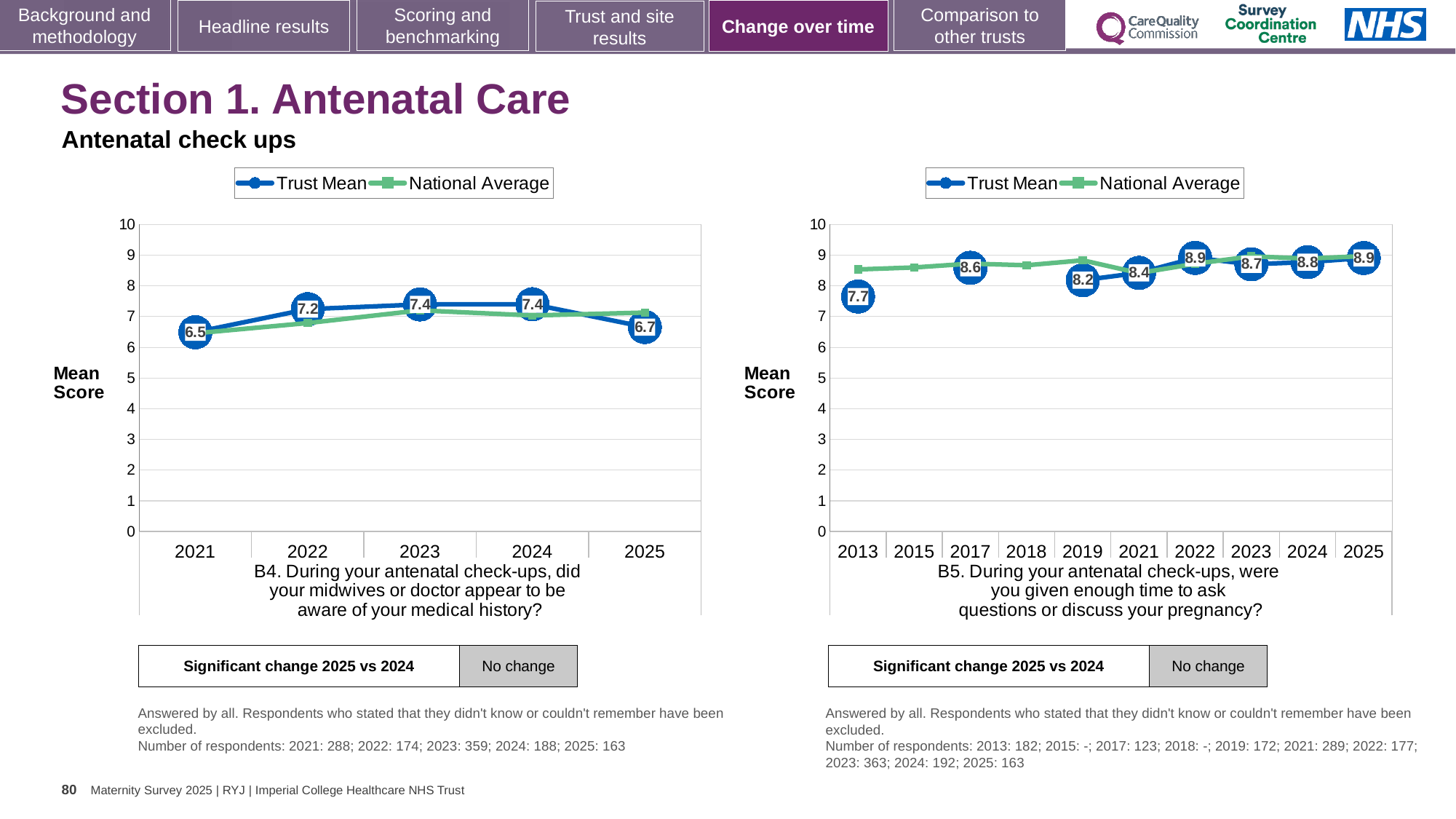
What type of chart is the left chart (B4)? Line chart In the left chart (B4), what is the Trust Mean for 2025? 6.7 In the right chart (B5), is the National Average for 2013 greater or less than 8? greater In the left chart (B4), what is the Trust Mean for 2022? 7.2 In the right chart (B5), how many years are shown on the x axis? 10 In the right chart (B5), which year has the lowest Trust Mean? 2013 In the right chart (B5), is the Trust Mean higher in 2022 or in 2023? 2022 In the left chart (B4), how many series does the legend list? 2 In the right chart (B5), what is the Trust Mean for 2019? 8.2 In the left chart (B4), which year has the lowest Trust Mean? 2021 In the left chart (B4), what is the difference between the Trust Mean in 2024 and in 2025? 0.7 In the right chart (B5), what is the Trust Mean for 2013? 7.7